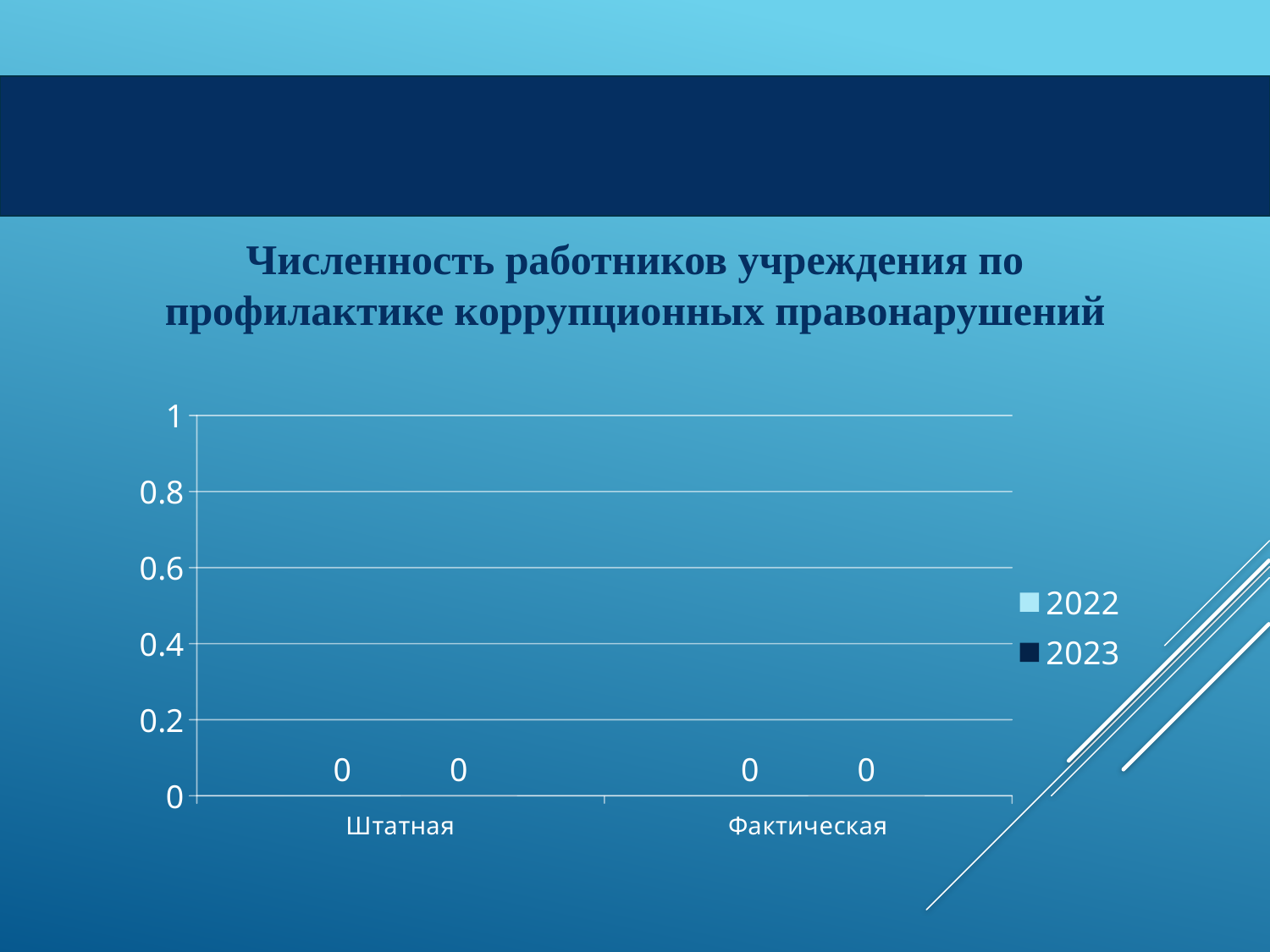
What is the difference between the 2023 values for Штатная and Фактическая? 0 What is the value for Штатная in 2022? 0 What kind of chart is shown on the slide? bar chart What is the value for Фактическая in 2023? 0 What is the value for Штатная in 2023? 0 How many series does the legend list? 2 What is the highest value shown on the vertical axis? 1 Which years are listed in the chart legend? 2022 and 2023 Is the value for Штатная in 2022 greater or less than 0.2? less What is the value for Фактическая in 2022? 0 How many categories are shown on the x axis of the chart? 2